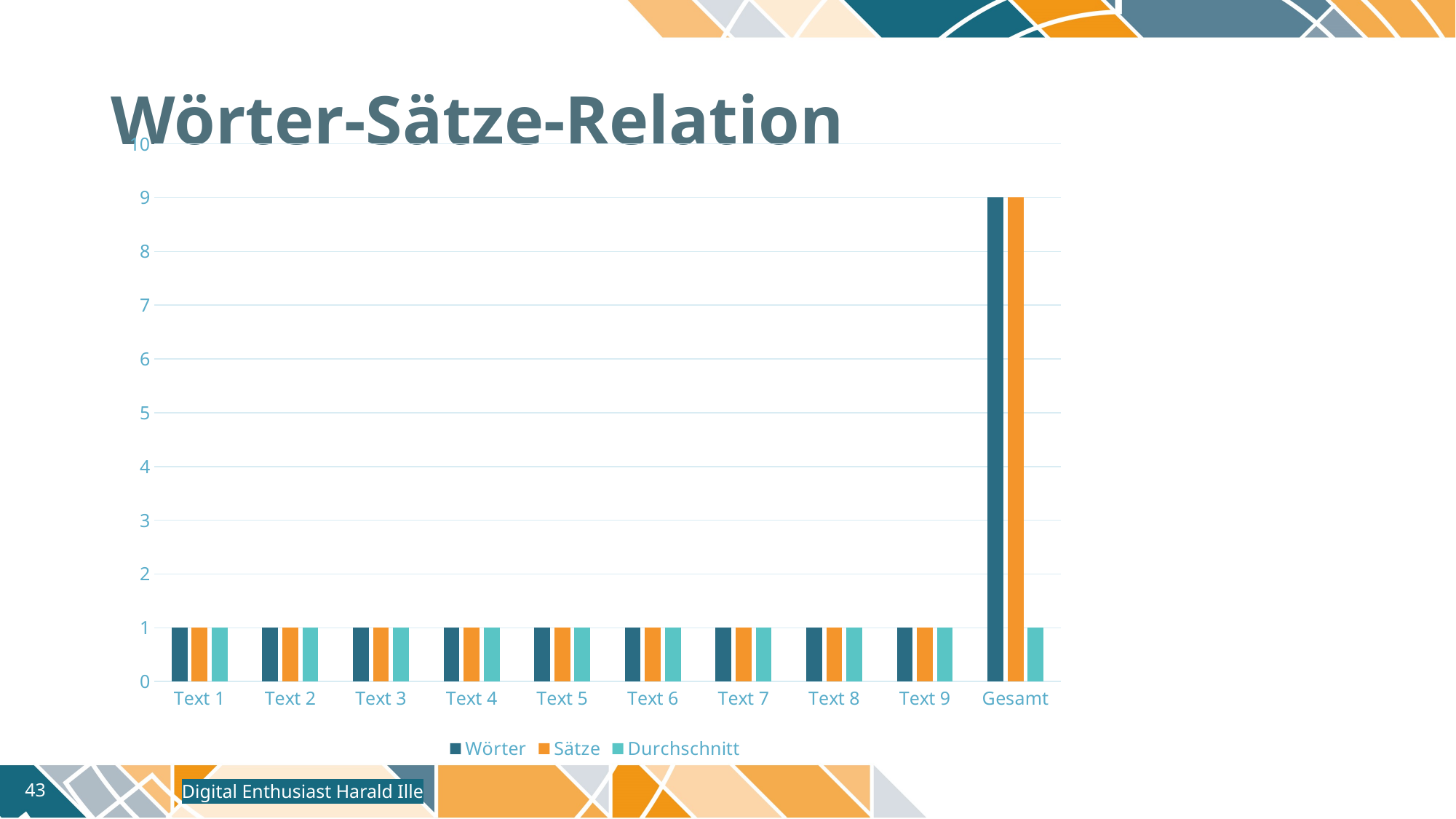
Which series is shown in orange in the legend? Sätze How many series does the legend list? 3 What is the value of Wörter for Gesamt? 9 What is the difference between the Wörter value and the Durchschnitt value for Gesamt? 8 Which is larger for Gesamt, the Sätze value or the Durchschnitt value? Sätze How many categories are shown on the x axis? 10 What is the value of Sätze for Gesamt? 9 Which category has the highest Wörter value? Gesamt What kind of chart is shown on the slide? bar chart What is the value of Wörter for Text 5? 1 Is the Wörter value for Gesamt greater or less than 5? greater What is the value of Durchschnitt for Gesamt? 1